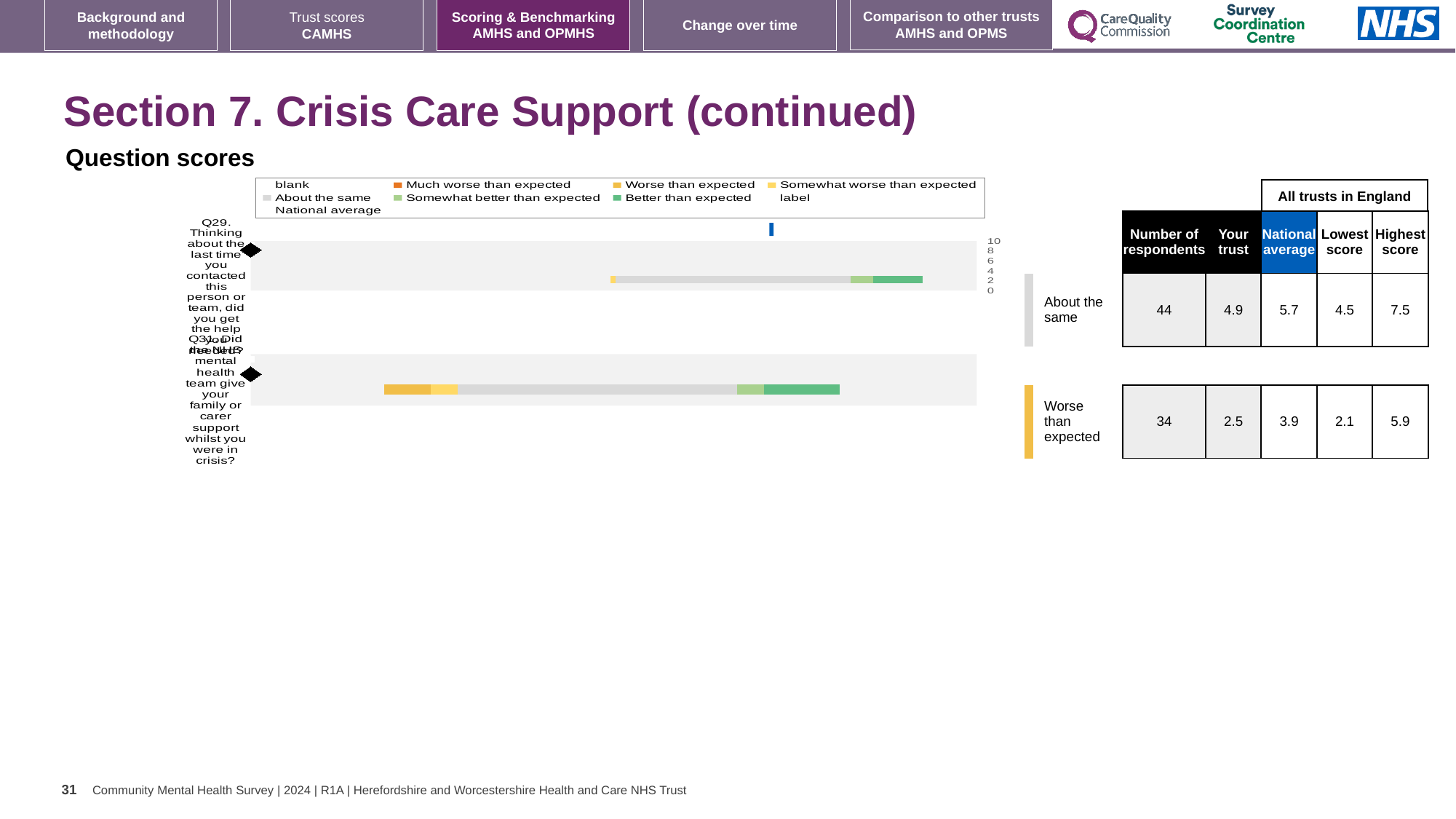
Which question has the higher 'Your trust' score, Q29 or Q31? Q29 What is the difference between the 'Your trust' scores for Q29 and Q31? 2.4 What is the national average score for Q29? 5.7 What kind of chart is shown under 'Question scores'? bar chart What is the 'Your trust' score for Q31 in the table beside the chart? 2.5 What is the highest tick value shown on the chart's axis? 10 How many entries does the chart legend list? 9 What is the 'Your trust' score for Q29 in the table beside the chart? 4.9 How many questions (categories) are plotted in the chart? 2 What colour does the legend use for 'Better than expected'? green What is the highest score across all trusts in England for Q31? 5.9 How many respondents answered Q31? 34